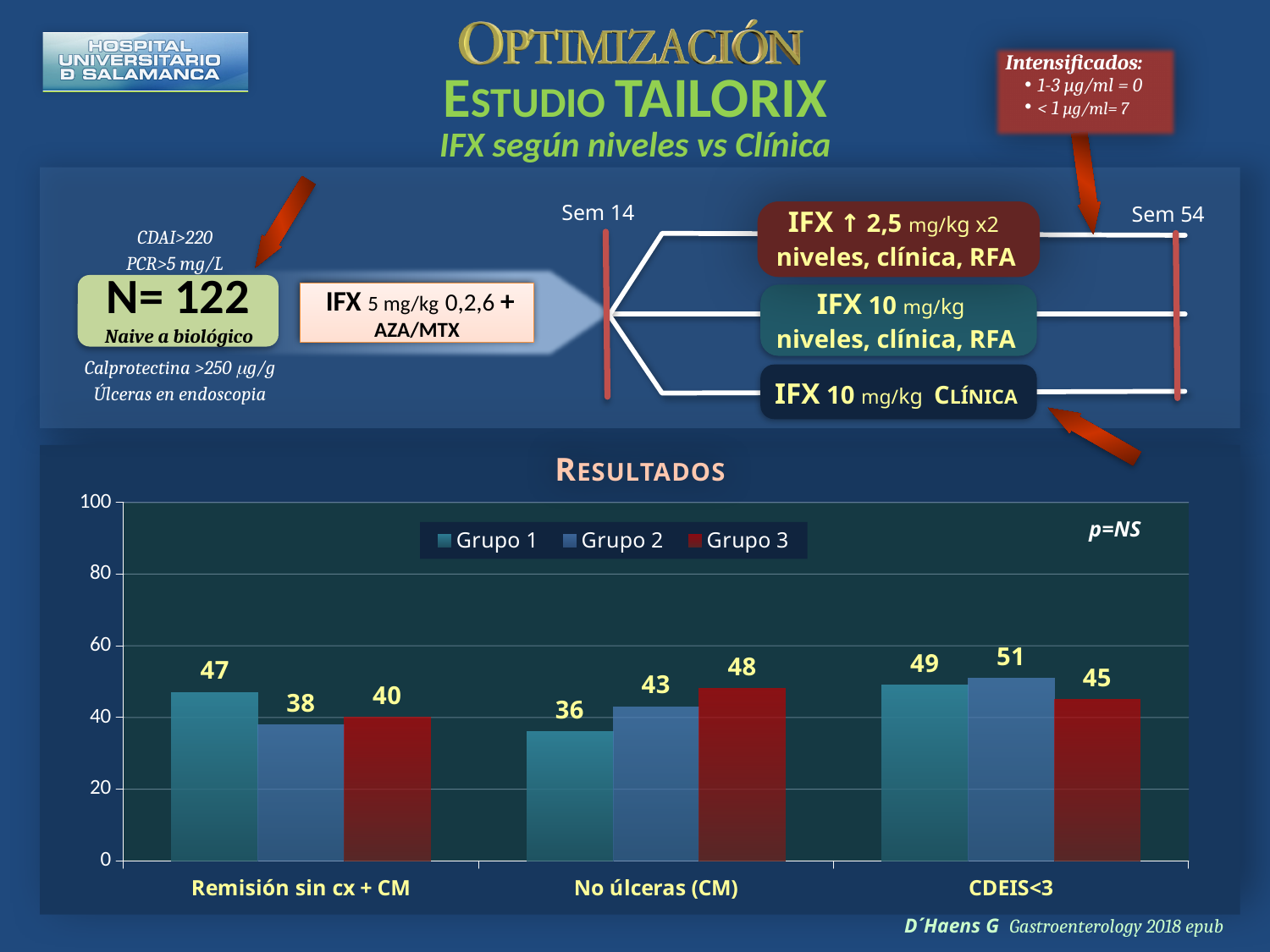
How many series does the legend list? 3 Which series has the lowest value in the Remisión sin cx + CM category? Grupo 2 Is the value for Grupo 1 in No úlceras (CM) greater or less than 40? less What is the difference between Grupo 1 and Grupo 2 in the Remisión sin cx + CM category? 9 What is the value for Grupo 3 in the No úlceras (CM) category? 48 How many categories are shown on the x axis of the chart? 3 Which series has the highest value in the No úlceras (CM) category? Grupo 3 What is the value for Grupo 1 in the Remisión sin cx + CM category? 47 Which is larger: Grupo 1 in CDEIS<3 or Grupo 3 in CDEIS<3? Grupo 1 in CDEIS<3 What is the value for Grupo 2 in the CDEIS<3 category? 51 What p-value annotation is shown on the chart? p=NS What kind of chart is shown under Resultados? bar chart